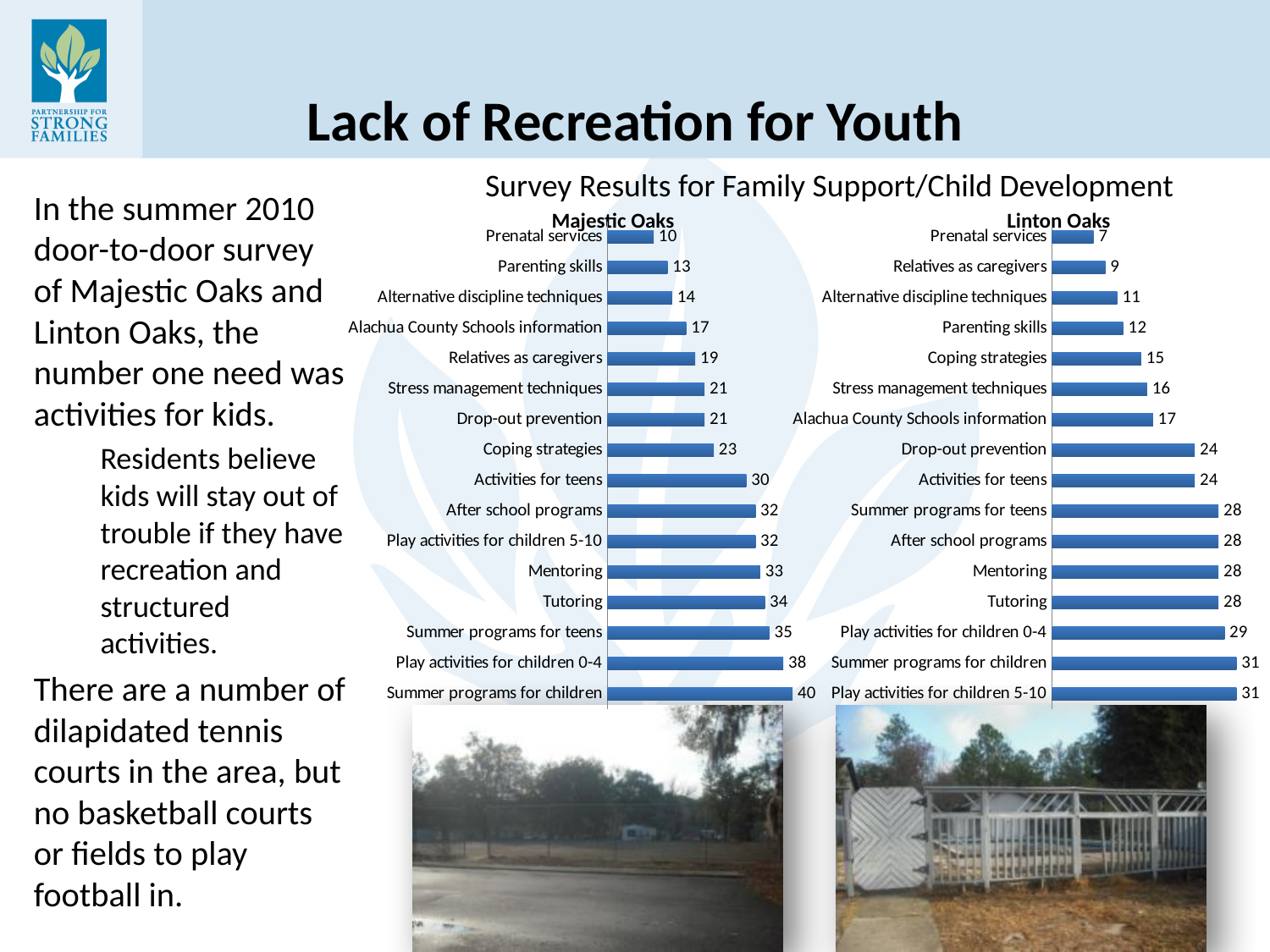
In the Linton Oaks chart, what is the value for Coping strategies? 15 In the Majestic Oaks chart, which category has the highest value? Summer programs for children In the Majestic Oaks chart, what is the difference between Play activities for children 0-4 and Prenatal services? 28 In the Majestic Oaks chart, which category has the lowest value? Prenatal services In the Linton Oaks chart, which is larger: Tutoring or Parenting skills? Tutoring In the Linton Oaks chart, which category has the lowest value? Prenatal services How many categories are shown in the Majestic Oaks chart? 16 What type of chart is the Linton Oaks chart? Bar chart In the Majestic Oaks chart, what is the value for Summer programs for children? 40 In the Majestic Oaks chart, what is the value for Mentoring? 33 In the Linton Oaks chart, what is the value for Drop-out prevention? 24 In the Linton Oaks chart, what is the difference between Summer programs for children and Alachua County Schools information? 14